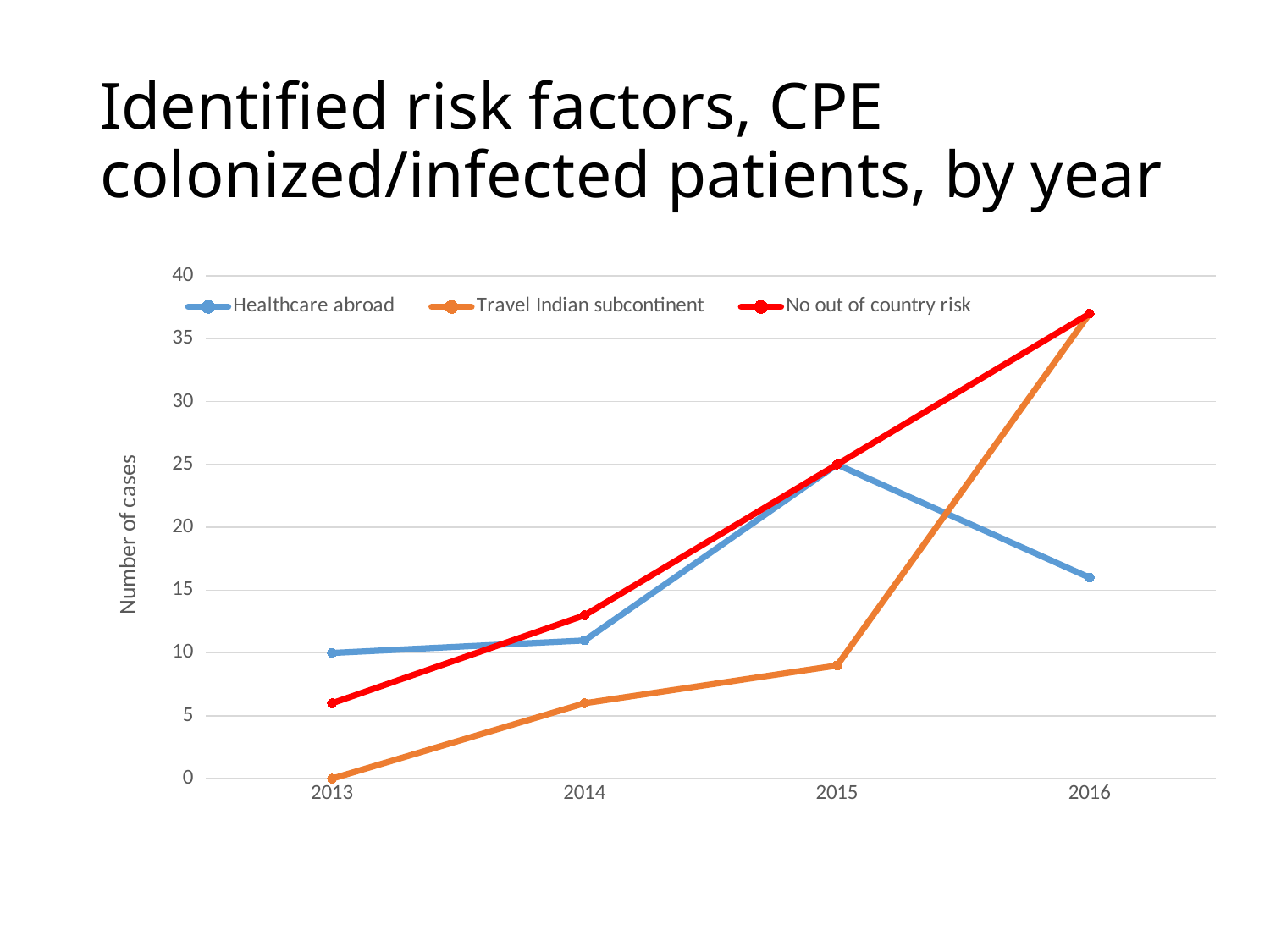
What is the number of cases for Travel Indian subcontinent in 2013? 0 What kind of chart is shown on the slide? line chart Which series has the lowest value in 2014? Travel Indian subcontinent How many series does the legend list? 3 How many years are shown on the x axis? 4 What is the label on the y axis? Number of cases Does the No out of country risk series rise or fall from 2013 to 2016? rise In 2016, which is larger: Healthcare abroad or Travel Indian subcontinent? Travel Indian subcontinent Is the value for Travel Indian subcontinent in 2015 greater or less than 10? less Is the value for No out of country risk in 2016 greater or less than 35? greater What is the number of cases for No out of country risk in 2015? 25 What is the number of cases for Healthcare abroad in 2013? 10